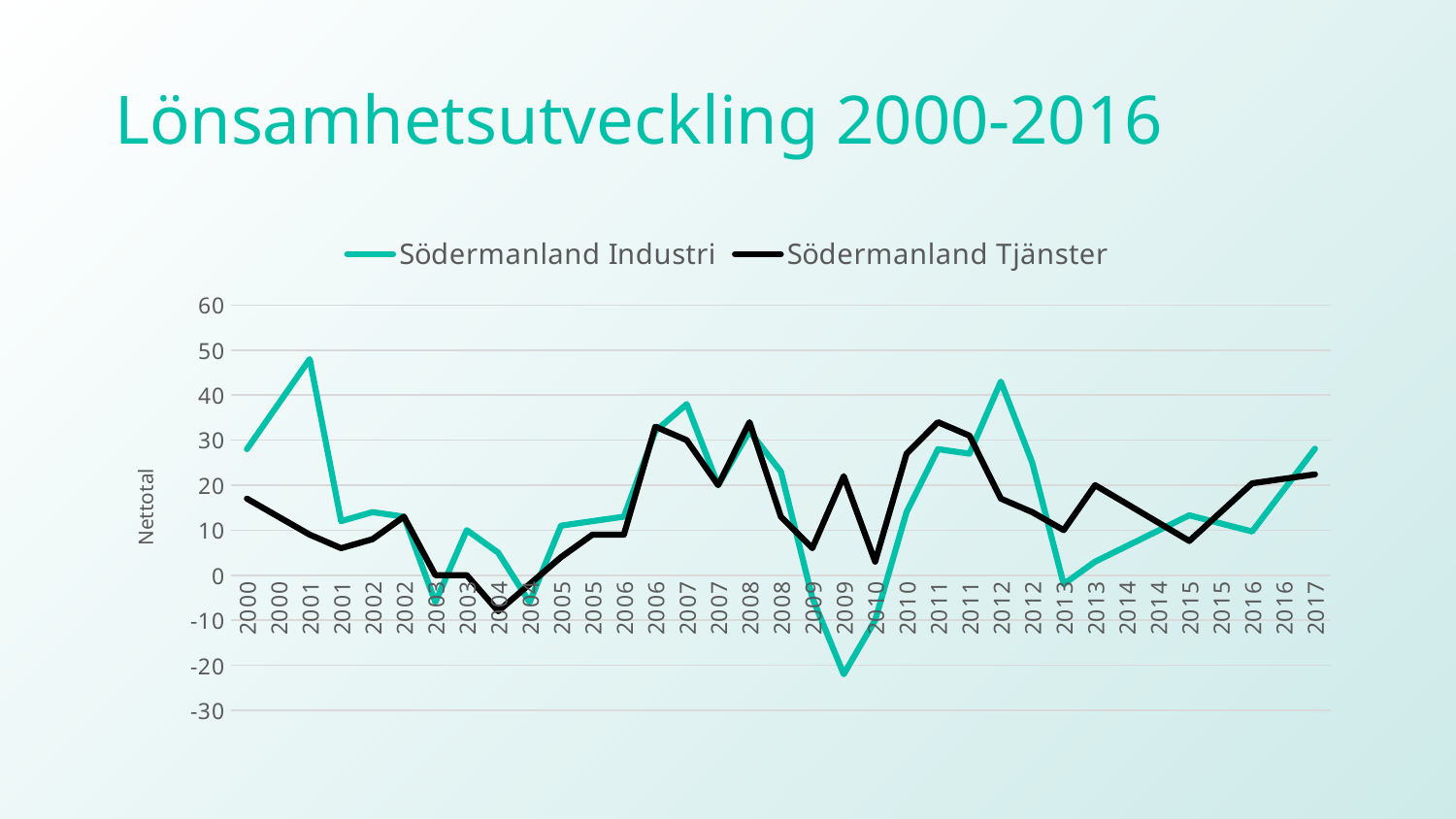
What are the two series named in the legend? Södermanland Industri and Södermanland Tjänster At the first 2001 point, which series has the larger value, Södermanland Industri or Södermanland Tjänster? Södermanland Industri Is the value for Södermanland Industri at the first 2001 point greater or less than 40? greater Which series reaches the lowest value anywhere on the chart? Södermanland Industri Which series reaches the highest value anywhere on the chart? Södermanland Industri How many series does the legend list? 2 Does the Södermanland Industri line rise or fall between the first 2001 point and the first 2002 point? fall At the second 2009 point, which series has the larger value, Södermanland Industri or Södermanland Tjänster? Södermanland Tjänster Is the value for Södermanland Tjänster at the first 2000 point greater or less than 10? greater What is the label on the vertical axis? Nettotal Is the value for Södermanland Industri at the second 2009 point greater or less than -10? less What kind of chart is shown on the slide? line chart